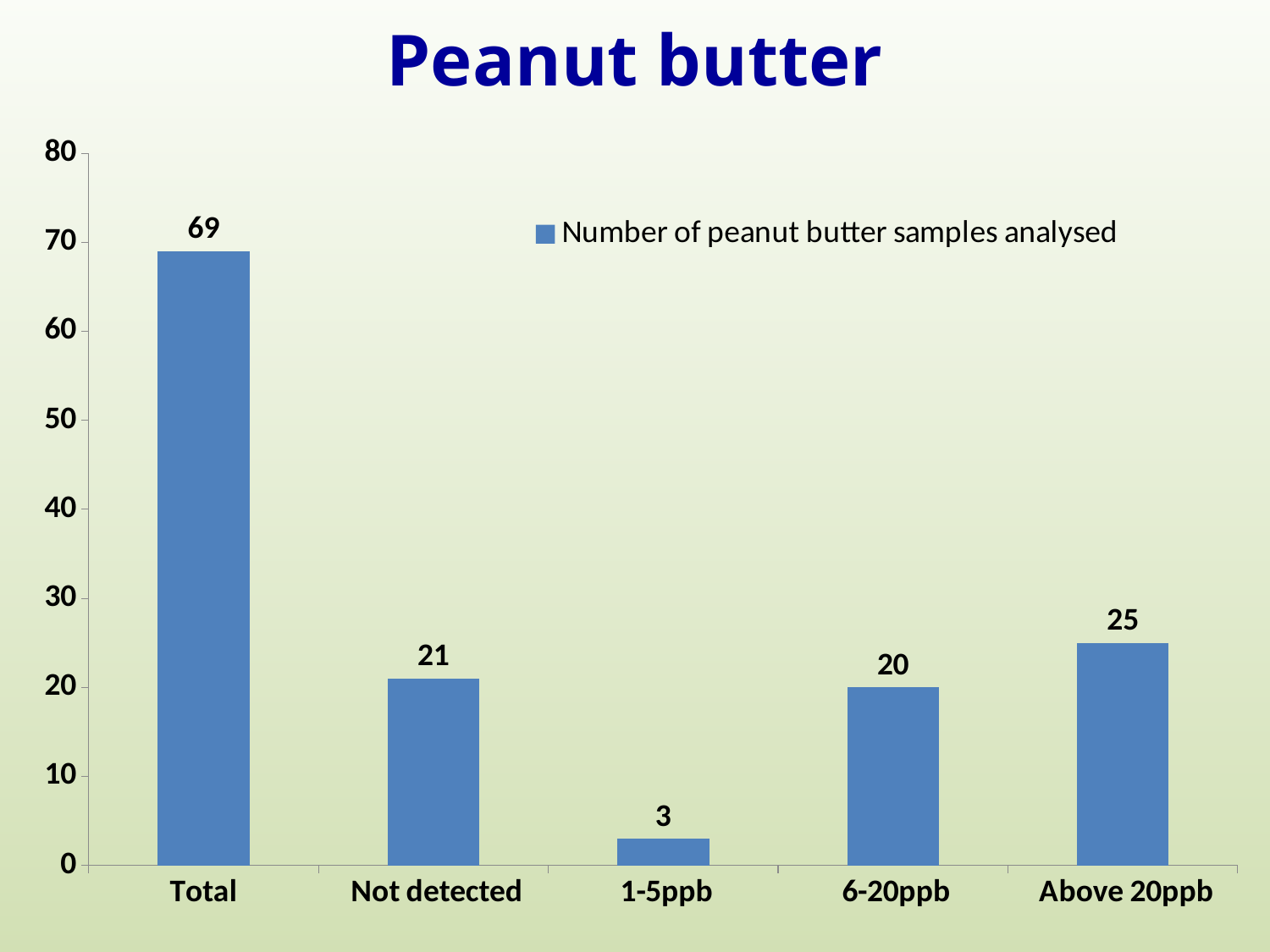
What is the difference between the values for Above 20ppb and 6-20ppb? 5 What is the value for Total? 69 Which is larger, the value for Not detected or the value for Above 20ppb? Above 20ppb Which category has the lowest value? 1-5ppb Is the value for 6-20ppb greater or less than 30? less What series name does the legend show? Number of peanut butter samples analysed What is the value for Not detected? 21 What is the value for Above 20ppb? 25 What kind of chart is shown on the slide? bar chart Which category has the highest value? Total How many categories are shown on the x axis? 5 What is the value for 1-5ppb? 3